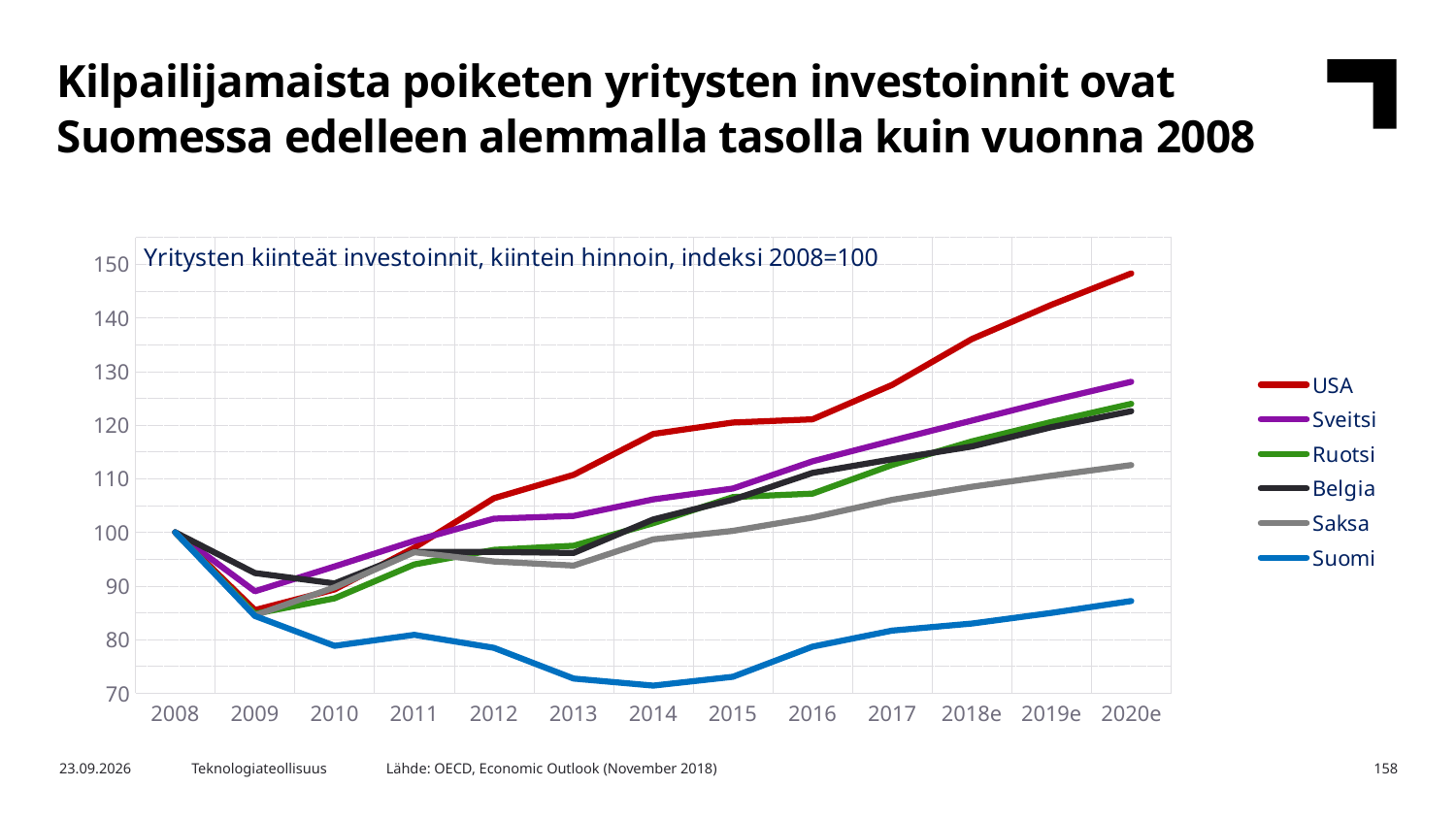
Which series has the lowest value in 2020e? Suomi Is the value for Suomi in 2014 greater or less than 80? less Which series has the highest value in 2020e? USA What is the title of the chart? Yritysten kiinteät investoinnit, kiintein hinnoin, indeksi 2008=100 Does the Suomi series rise or fall from 2008 to 2014? fall What is the value of the USA series in 2008? 100 Is the value for USA in 2020e greater or less than 140? greater How many series does the legend list? 6 What kind of chart is shown on the slide? line chart In 2020e, which is larger: the value for Sveitsi or the value for Saksa? Sveitsi Is the value for Saksa in 2020e greater or less than 110? greater How many years are shown on the x axis? 13